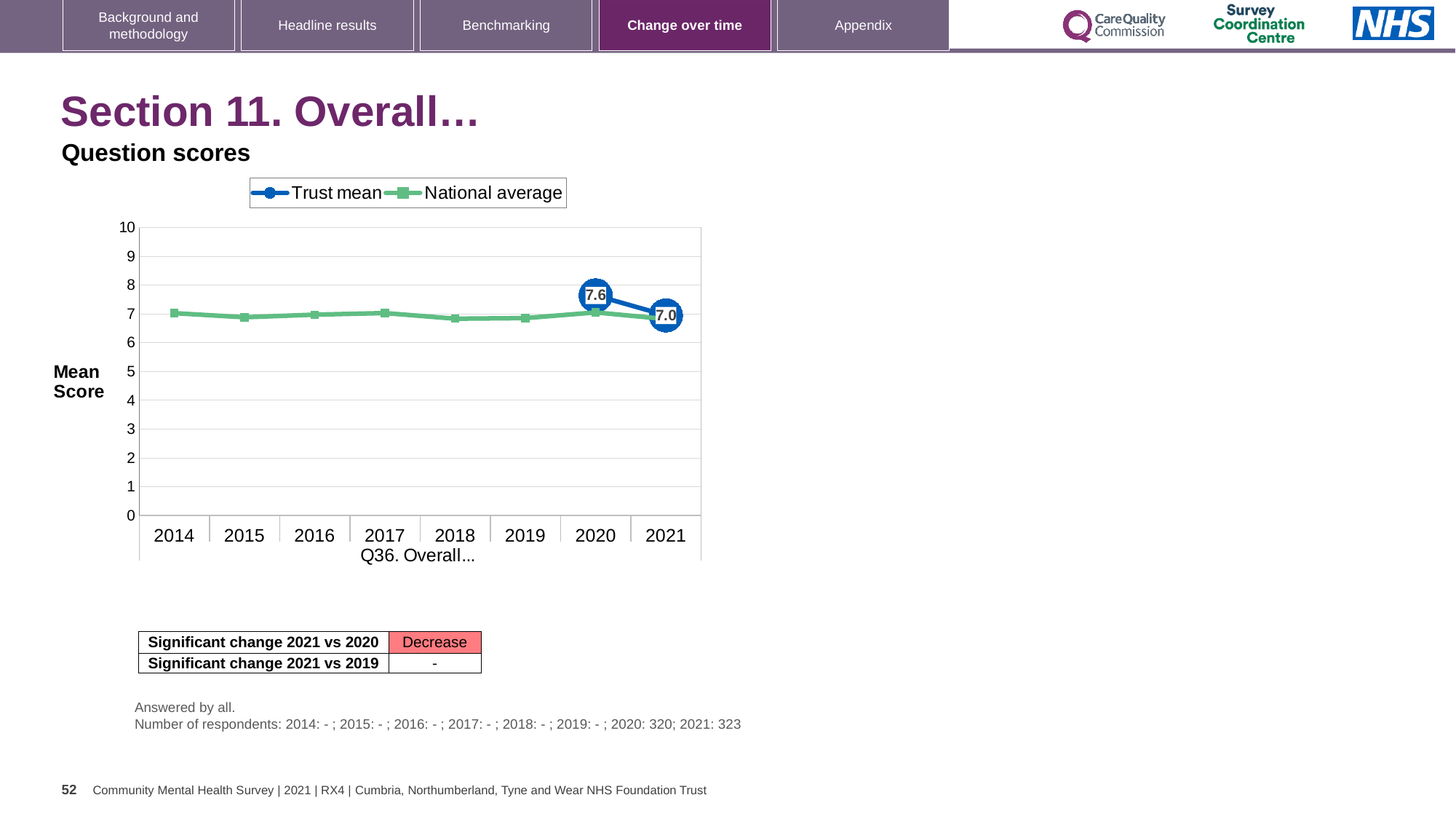
By how much did the Trust mean change between 2020 and 2021? 0.6 What is the Trust mean value for 2021? 7.0 Is the National average value for 2018 greater or less than 8? less Which year has the higher Trust mean, 2020 or 2021? 2020 What is the Trust mean value for 2020? 7.6 How many years are shown on the x axis of the chart? 8 What kind of chart is shown on the slide? line chart Is the National average value for 2014 greater or less than 5? greater How many series does the chart legend list? 2 Does the Trust mean rise or fall from 2020 to 2021? fall What is the label on the y axis of the chart? Mean Score In 2020, which series has the higher value, Trust mean or National average? Trust mean